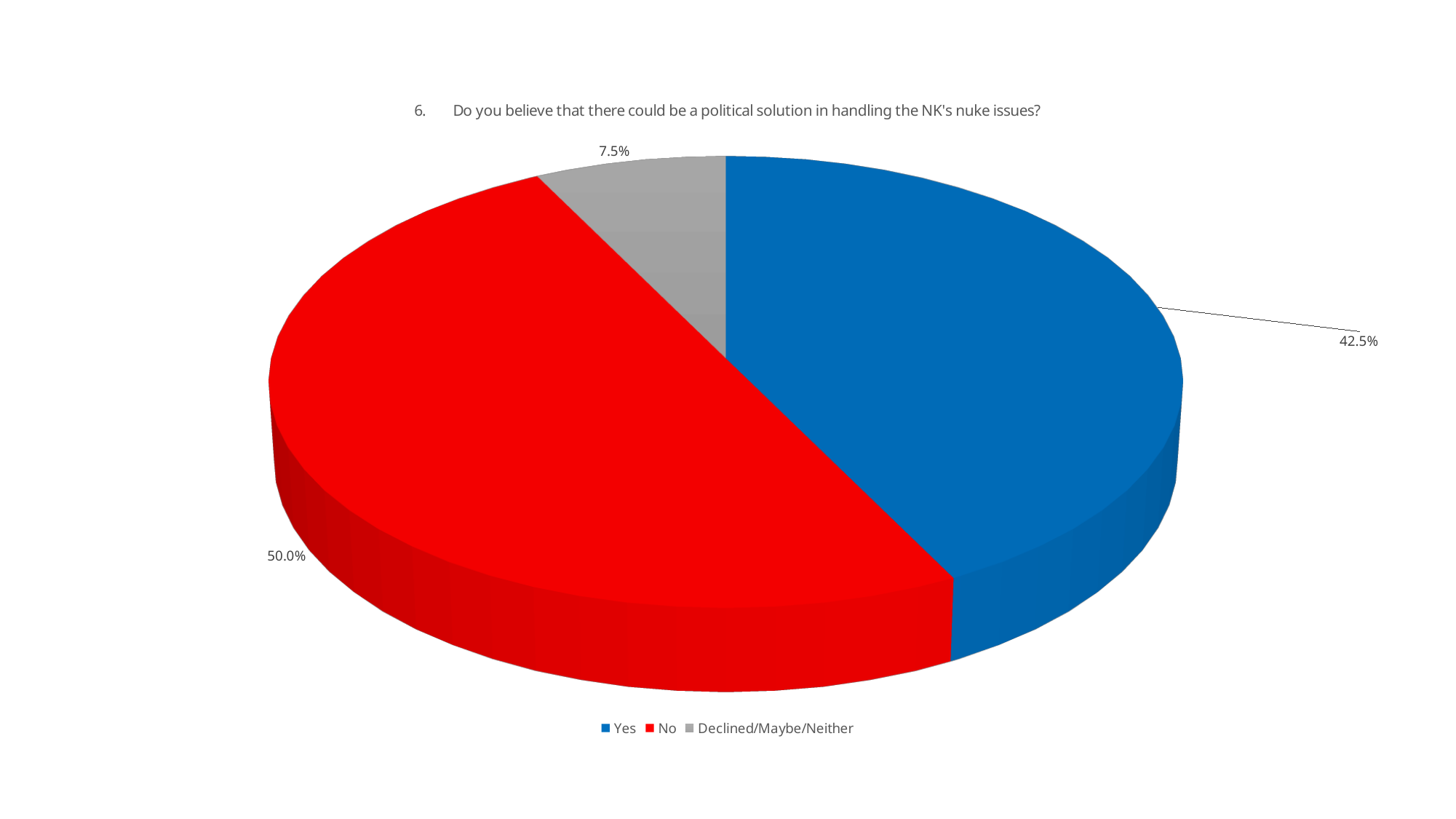
What kind of chart is shown on the slide? Pie chart What is the title of the chart? 6. Do you believe that there could be a political solution in handling the NK's nuke issues? How many slices does the pie chart have? 3 What percentage of respondents answered "Yes"? 42.5% Which response has the largest share of the pie? No What percentage of respondents fall under "Declined/Maybe/Neither"? 7.5% Which is larger, the "Yes" slice or the "Declined/Maybe/Neither" slice? Yes Which response has the smallest share of the pie? Declined/Maybe/Neither What is the difference in percentage points between the "No" and "Yes" slices? 7.5 How many entries does the legend list? 3 What percentage of respondents answered "No"? 50.0% What colour is the "No" slice? Red